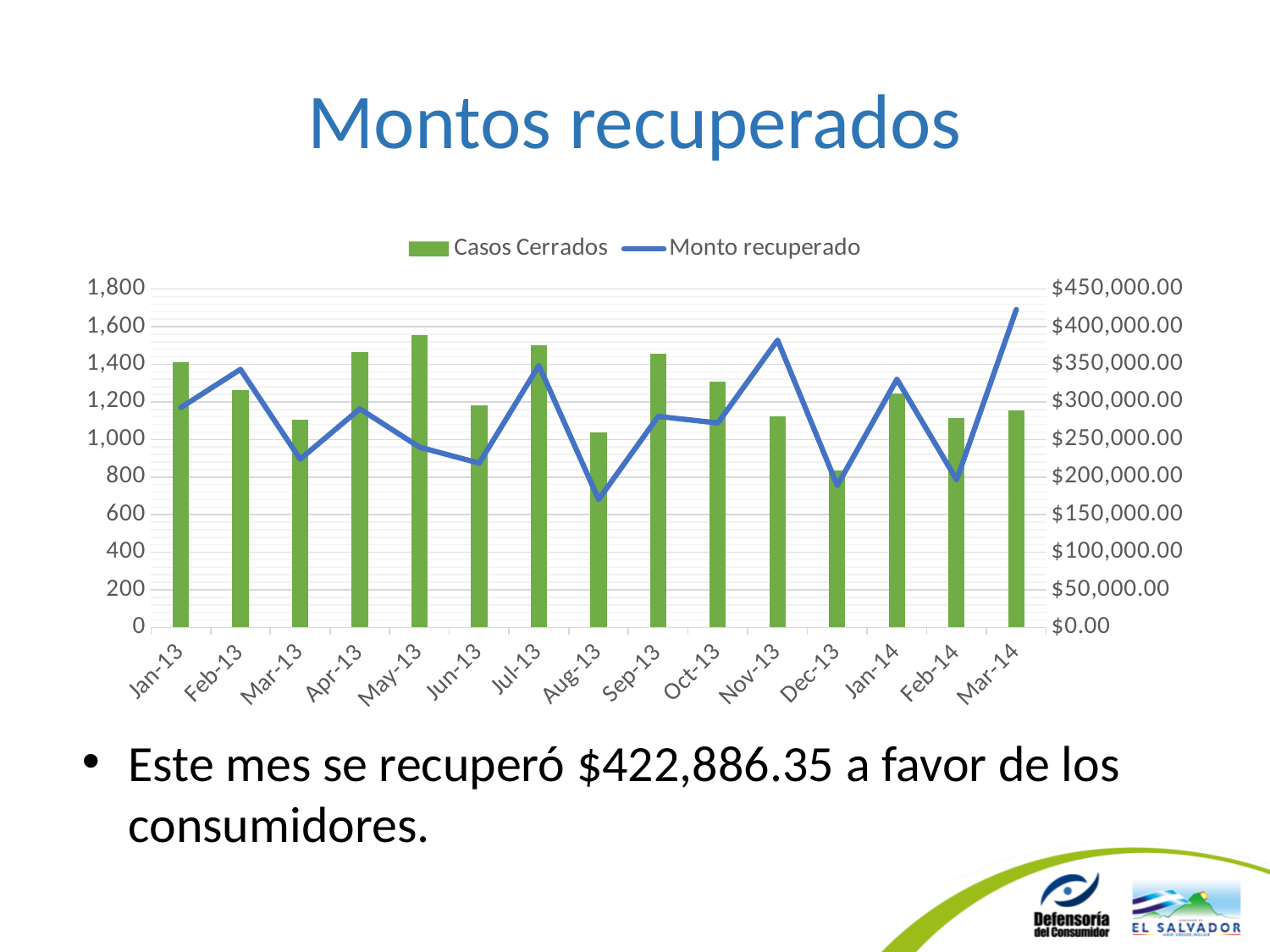
Which month has the lowest number of Casos Cerrados? Dec-13 Which month has the lowest Monto recuperado? Aug-13 Which month had more Casos Cerrados, Jan-13 or Mar-13? Jan-13 Which month has the highest number of Casos Cerrados? May-13 Is the Monto recuperado for Mar-14 greater or less than $400,000.00? greater Is the Casos Cerrados value for Dec-13 greater or less than 1,000? less How many months are plotted along the x axis? 15 What kind of chart is shown on the slide? A combination bar and line chart Is the Monto recuperado for Aug-13 greater or less than $200,000.00? less Which series is drawn as green bars? Casos Cerrados Which month has the highest Monto recuperado? Mar-14 How many series does the legend list? 2